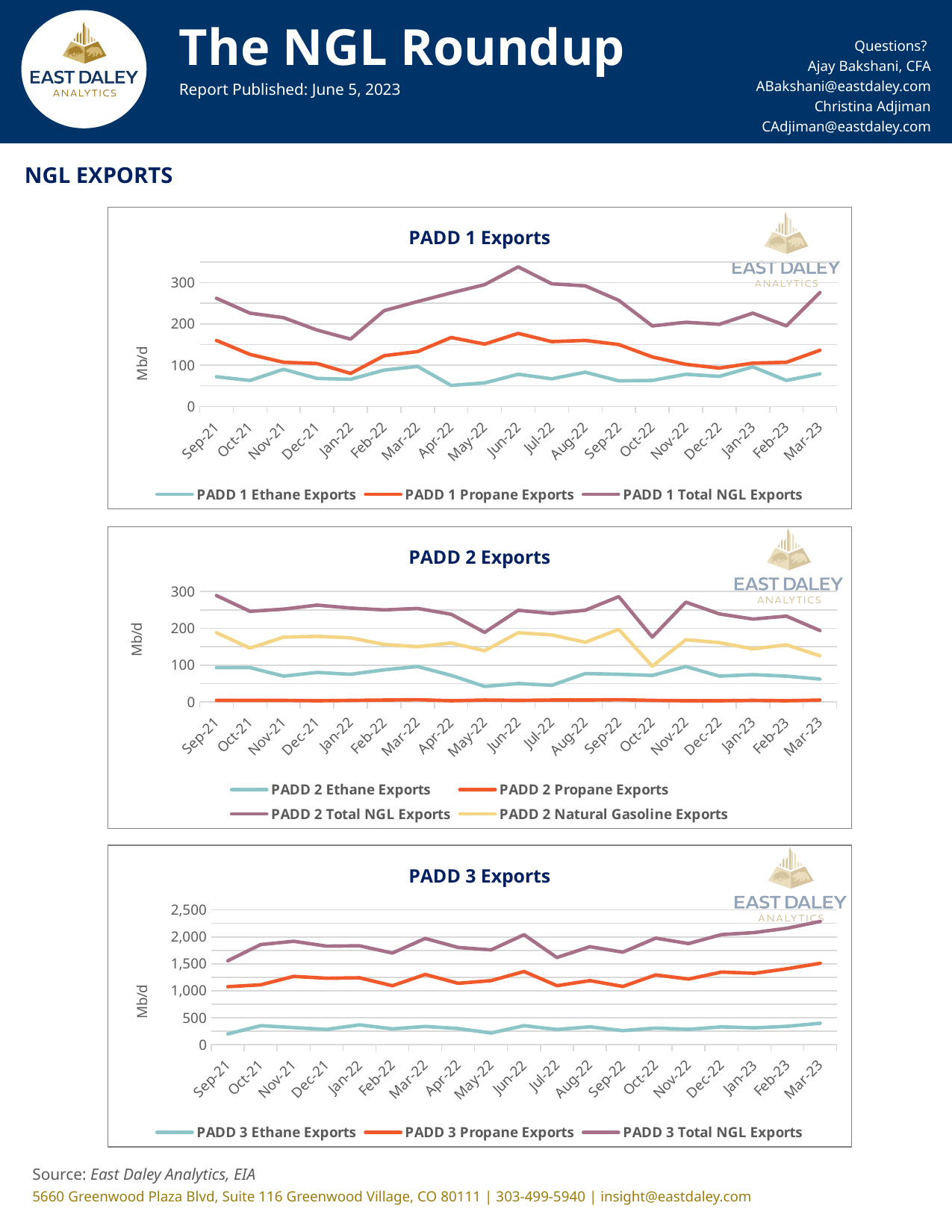
How many months are plotted along the x axis of the PADD 1 Exports chart? 19 How many series does the legend of the PADD 2 Exports chart list? 4 In the PADD 2 Exports chart, in which month is PADD 2 Total NGL Exports lowest? Oct-22 In the PADD 3 Exports chart, in which month is PADD 3 Total NGL Exports highest? Mar-23 What type of chart is the PADD 1 Exports chart? line chart How many series does the legend of the PADD 3 Exports chart list? 3 In the PADD 2 Exports chart, is the value for PADD 2 Ethane Exports in May-22 greater or less than 100? less In the PADD 1 Exports chart, is the value for PADD 1 Total NGL Exports in Jun-22 greater or less than 300? greater What unit is shown on the y axis of the PADD 3 Exports chart? Mb/d In the PADD 3 Exports chart, which is larger in Jun-22: PADD 3 Propane Exports or PADD 3 Ethane Exports? PADD 3 Propane Exports In the PADD 1 Exports chart, in which month is PADD 1 Total NGL Exports highest? Jun-22 In the PADD 1 Exports chart, in which month is PADD 1 Propane Exports lowest? Jan-22